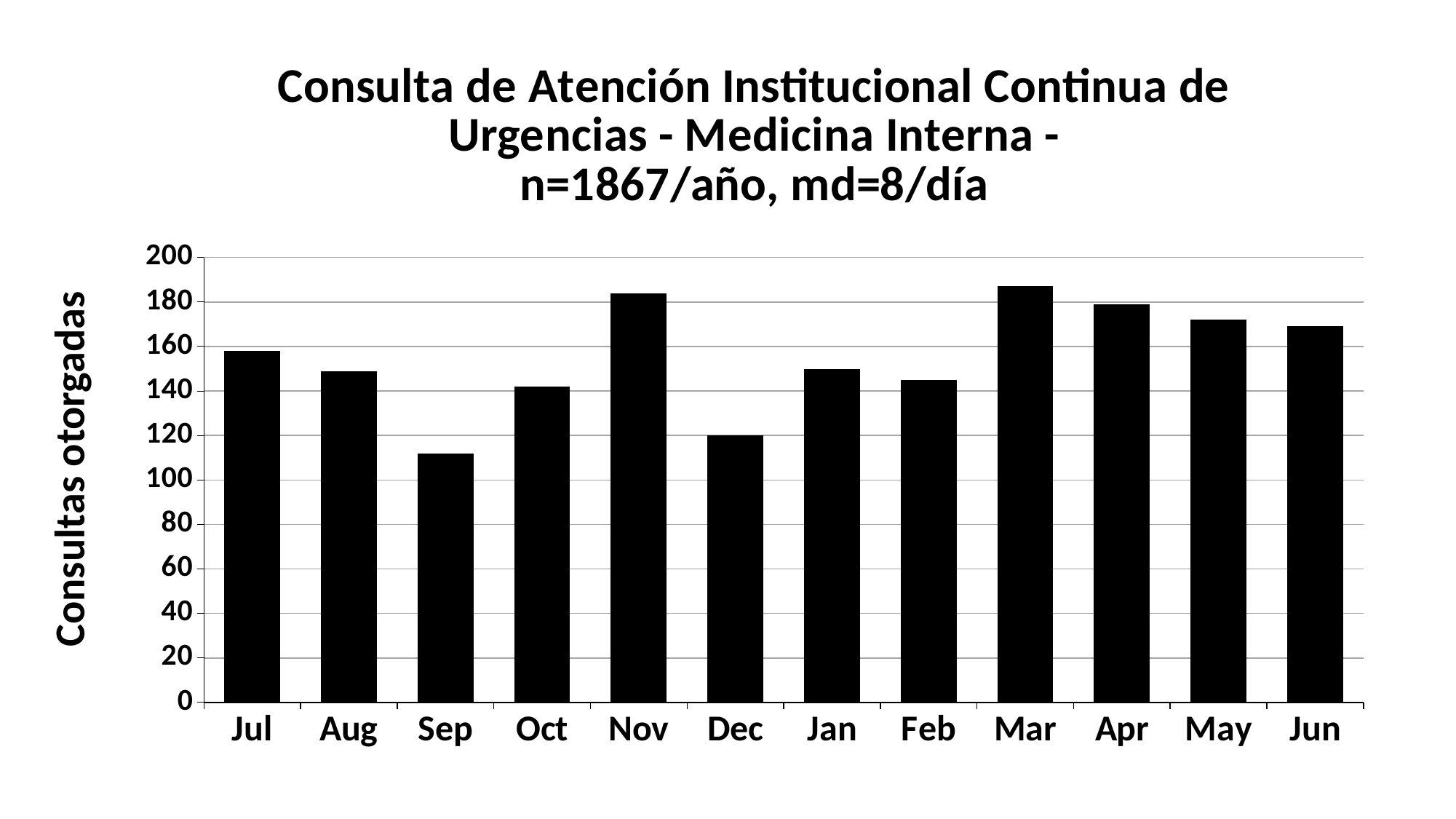
Is the value for Dec greater or less than 140? less Which month has the highest number of consultas otorgadas? Mar Which is larger, the value for Nov or the value for Dec? Nov Which is larger, the value for Sep or the value for Oct? Oct Which month has the lowest number of consultas otorgadas? Sep What is the label on the vertical axis? Consultas otorgadas Is the value for Sep greater or less than 120? less How many months are plotted on the x axis? 12 What kind of chart is shown on the slide? bar chart Is the value for Jun greater or less than 160? greater Do the values rise or fall from Sep to Nov? rise